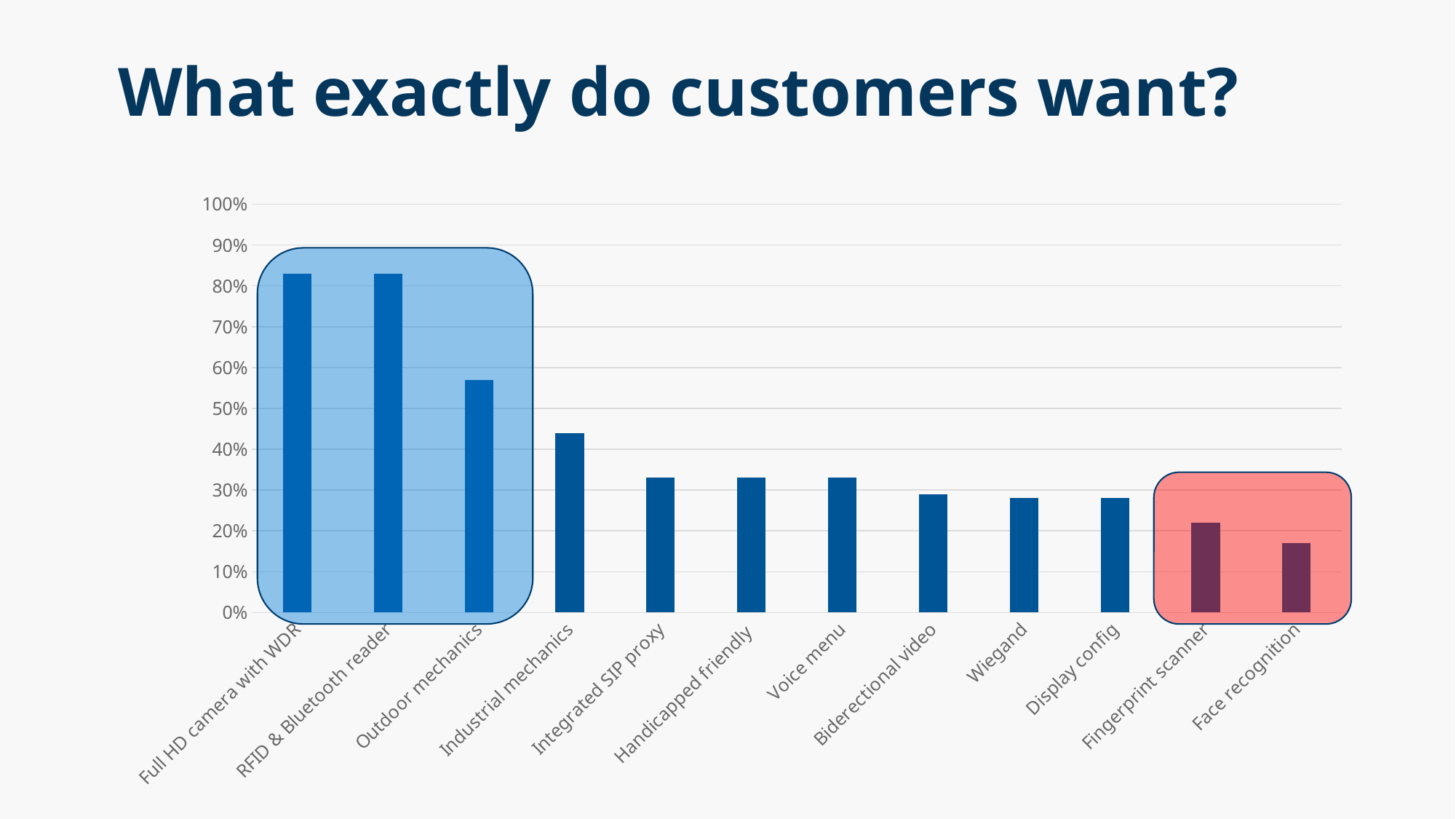
What is the title of the slide? What exactly do customers want? Which is larger, the value for Fingerprint scanner or the value for Face recognition? Fingerprint scanner What kind of chart is shown on the slide? Bar chart Is the value for Industrial mechanics greater or less than 50%? less How many categories are plotted on the chart? 12 Is the value for Outdoor mechanics greater or less than 50%? greater Do the values generally rise or fall moving from left to right along the x axis? Fall Which category has the lowest value on the chart? Face recognition Is the value for Wiegand greater or less than 20%? greater Which is larger, the value for Outdoor mechanics or the value for Industrial mechanics? Outdoor mechanics